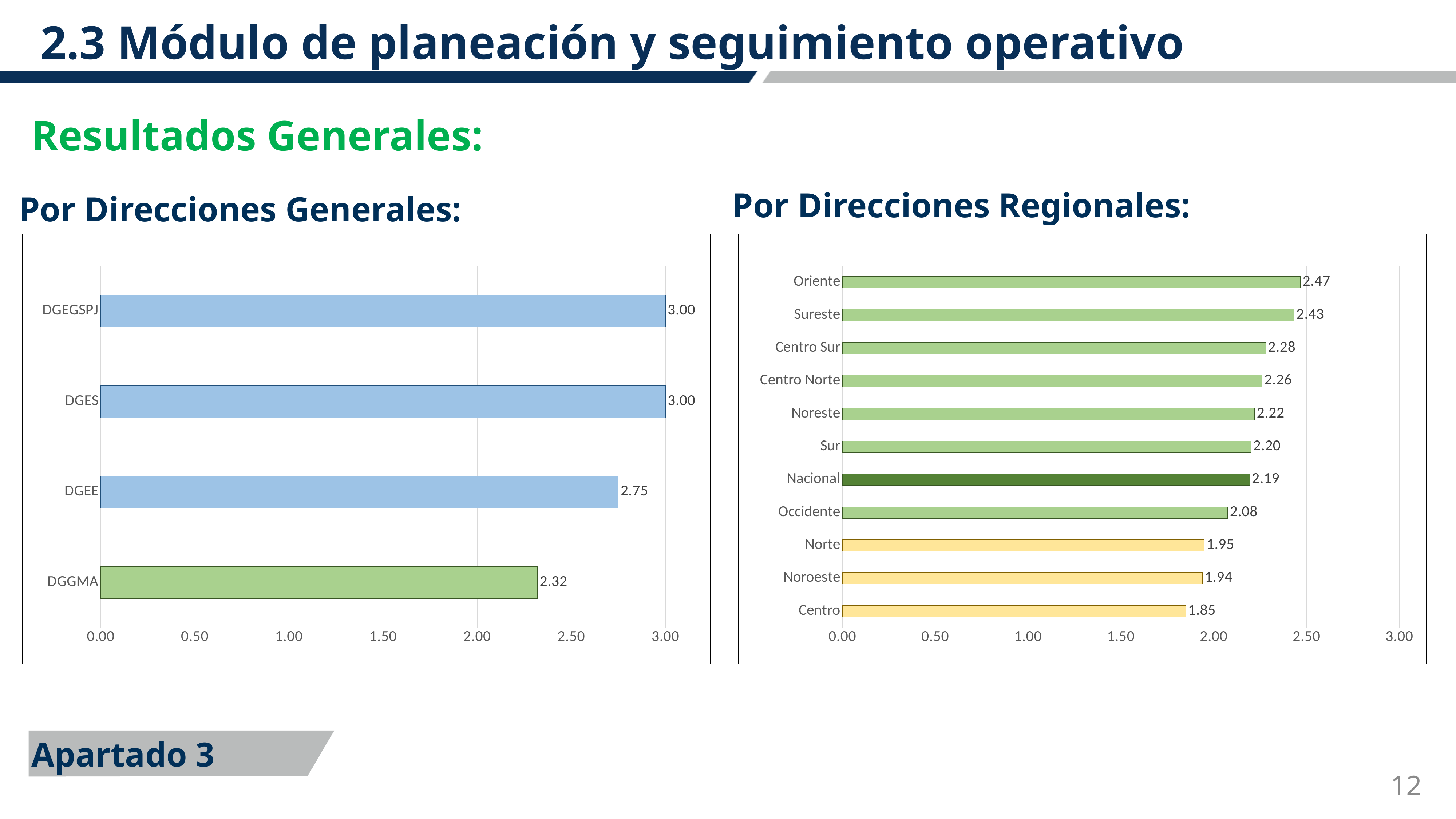
In the 'Por Direcciones Generales' chart, which category has the lowest value? DGGMA In the 'Por Direcciones Regionales' chart, what is the difference between the values for Oriente and Centro? 0.62 In the 'Por Direcciones Regionales' chart, what is the value for Noreste? 2.22 In the 'Por Direcciones Generales' chart, how many categories are shown? 4 In the 'Por Direcciones Generales' chart, what is the value for DGEE? 2.75 In the 'Por Direcciones Regionales' chart, what is the value for Nacional? 2.19 In the 'Por Direcciones Regionales' chart, which category has the lowest value? Centro In the 'Por Direcciones Generales' chart, what is the difference between the values for DGEE and DGGMA? 0.43 What kind of chart is the 'Por Direcciones Regionales' chart? Bar chart In the 'Por Direcciones Generales' chart, what is the value for DGGMA? 2.32 In the 'Por Direcciones Regionales' chart, how many categories are shown? 11 In the 'Por Direcciones Regionales' chart, which category has the highest value? Oriente